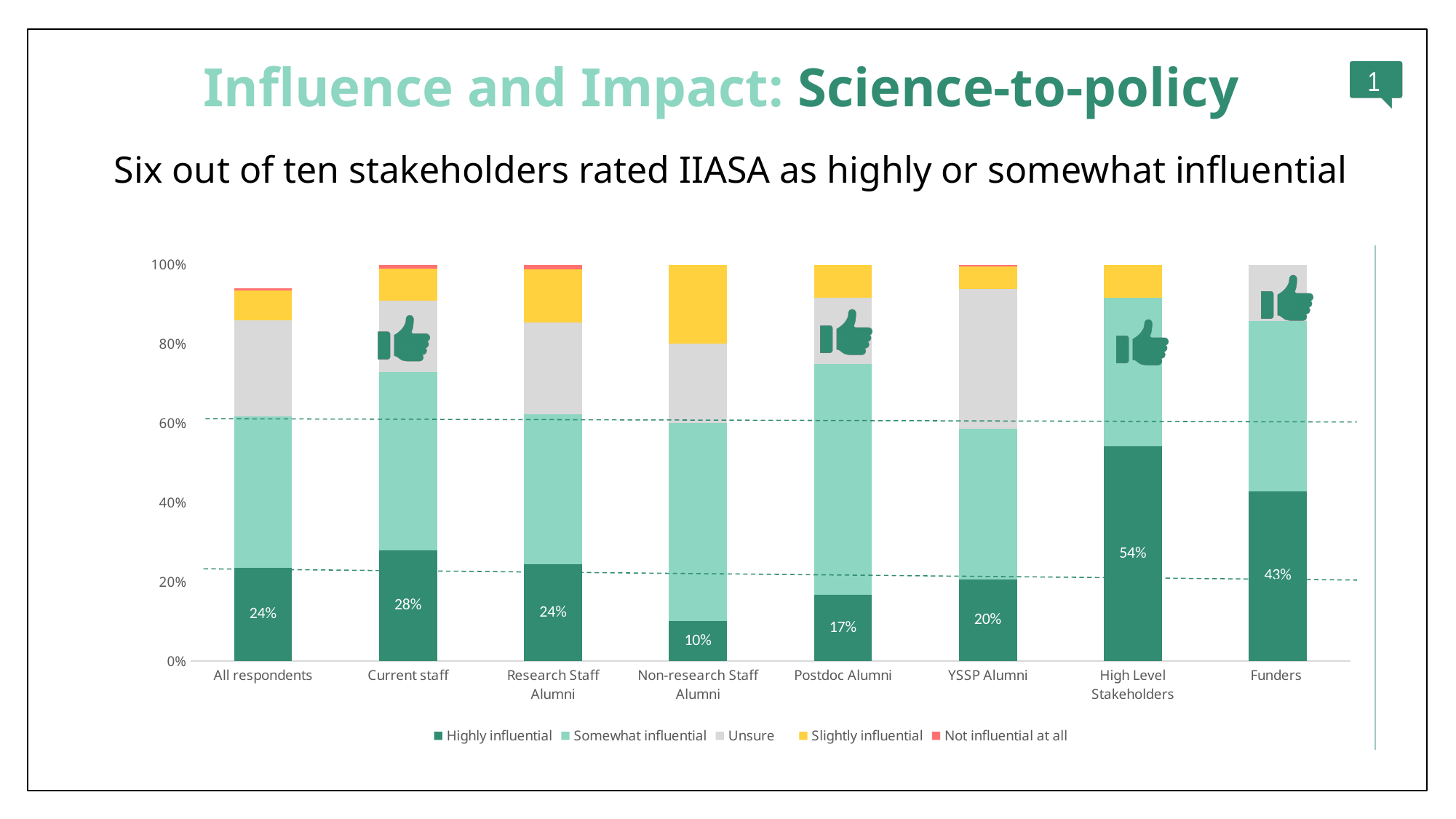
How many series does the legend list? 5 Which has a larger Highly influential value, Current staff or YSSP Alumni? Current staff What is the Highly influential value for High Level Stakeholders? 54% Which category has the highest Highly influential value? High Level Stakeholders Which category has the lowest Highly influential value? Non-research Staff Alumni What is the Highly influential value for Postdoc Alumni? 17% What is the difference between the Highly influential values for High Level Stakeholders and Funders? 11 percentage points What is the Highly influential value for Non-research Staff Alumni? 10% What kind of chart is shown on the slide? Stacked bar chart How many respondent categories are shown on the x axis? 8 What is the Highly influential value for Funders? 43% Is the combined Highly influential and Somewhat influential share for High Level Stakeholders greater or less than 80%? greater